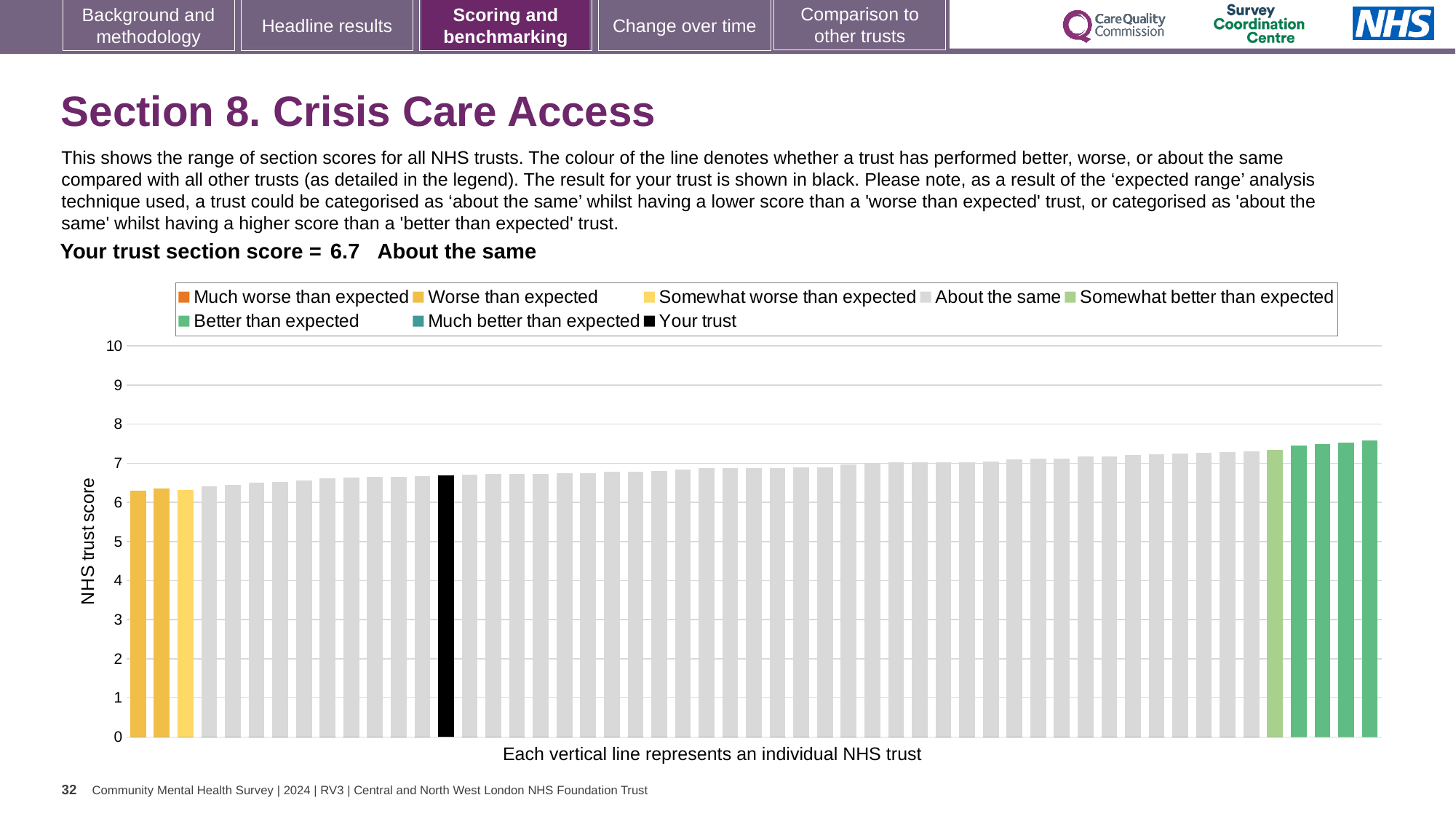
Is the value of the black bar (your trust) greater or less than 6? greater Do the bar values rise or fall from left to right across the chart? Rise How many bars are coloured as 'Worse than expected' (yellow) in the chart? 2 How many bars are coloured as 'Better than expected' (green) in the chart? 4 What is the section score for your trust shown on the slide? 6.7 Which category is your trust placed in for Crisis Care Access? About the same Is the value of the tallest bar in the chart greater or less than 7? greater What kind of chart is shown on the slide? Bar chart How many entries does the chart legend list? 8 Is the value of the shortest bar in the chart greater or less than 6? greater What is the label on the vertical axis of the chart? NHS trust score